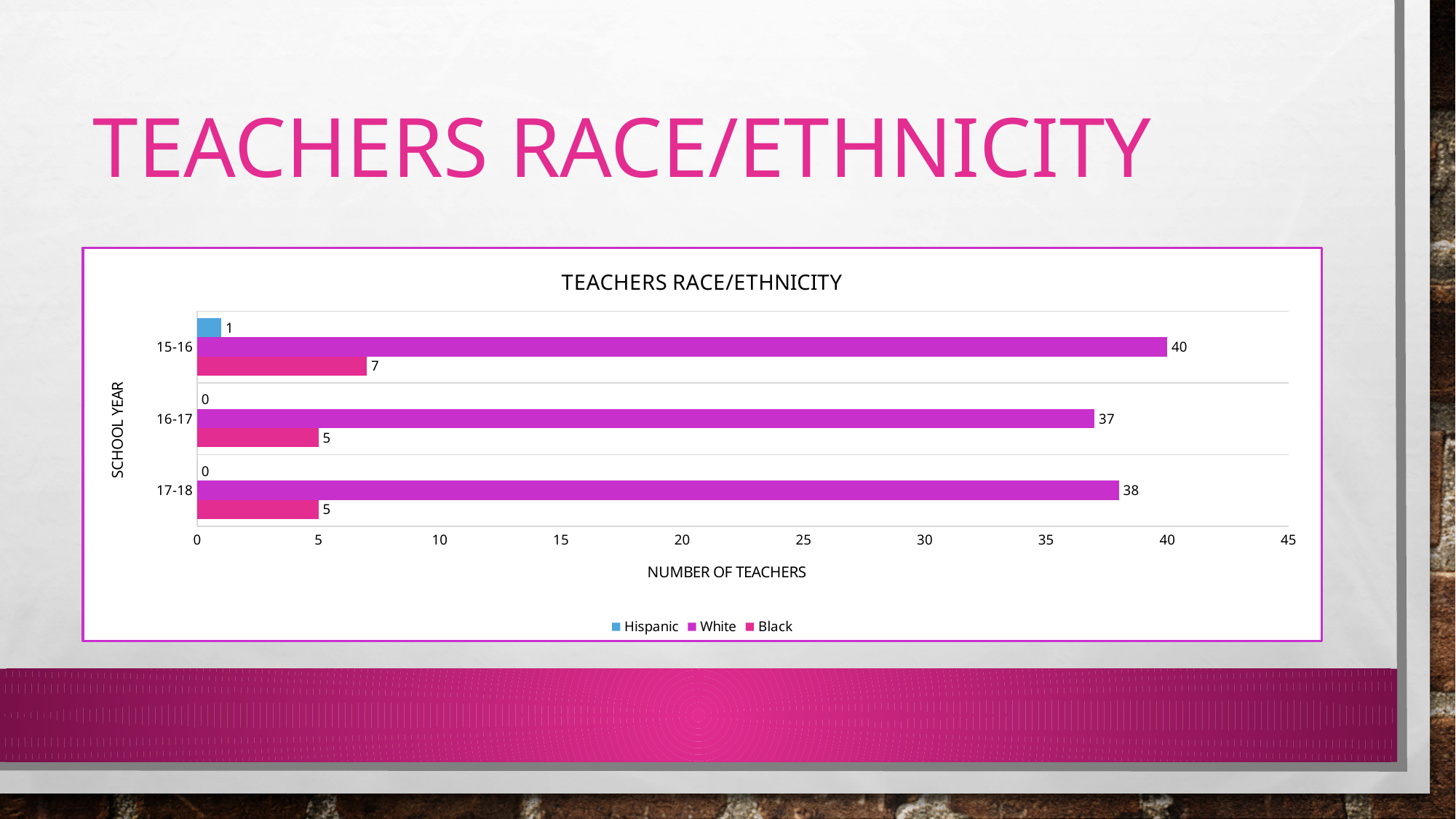
How many Black teachers were there in the 16-17 school year? 5 What is the label of the horizontal axis? NUMBER OF TEACHERS Which school year had the highest number of White teachers? 15-16 How many Hispanic teachers were there in the 15-16 school year? 1 Which school year had the lowest number of White teachers? 16-17 How many White teachers were there in the 15-16 school year? 40 Were there more Black teachers in 15-16 or in 17-18? 15-16 How many series does the legend list? 3 How many White teachers were there in the 17-18 school year? 38 How many school years are shown on the chart? 3 What kind of chart is shown on the slide? Bar chart What is the difference between the number of White teachers in 15-16 and in 16-17? 3